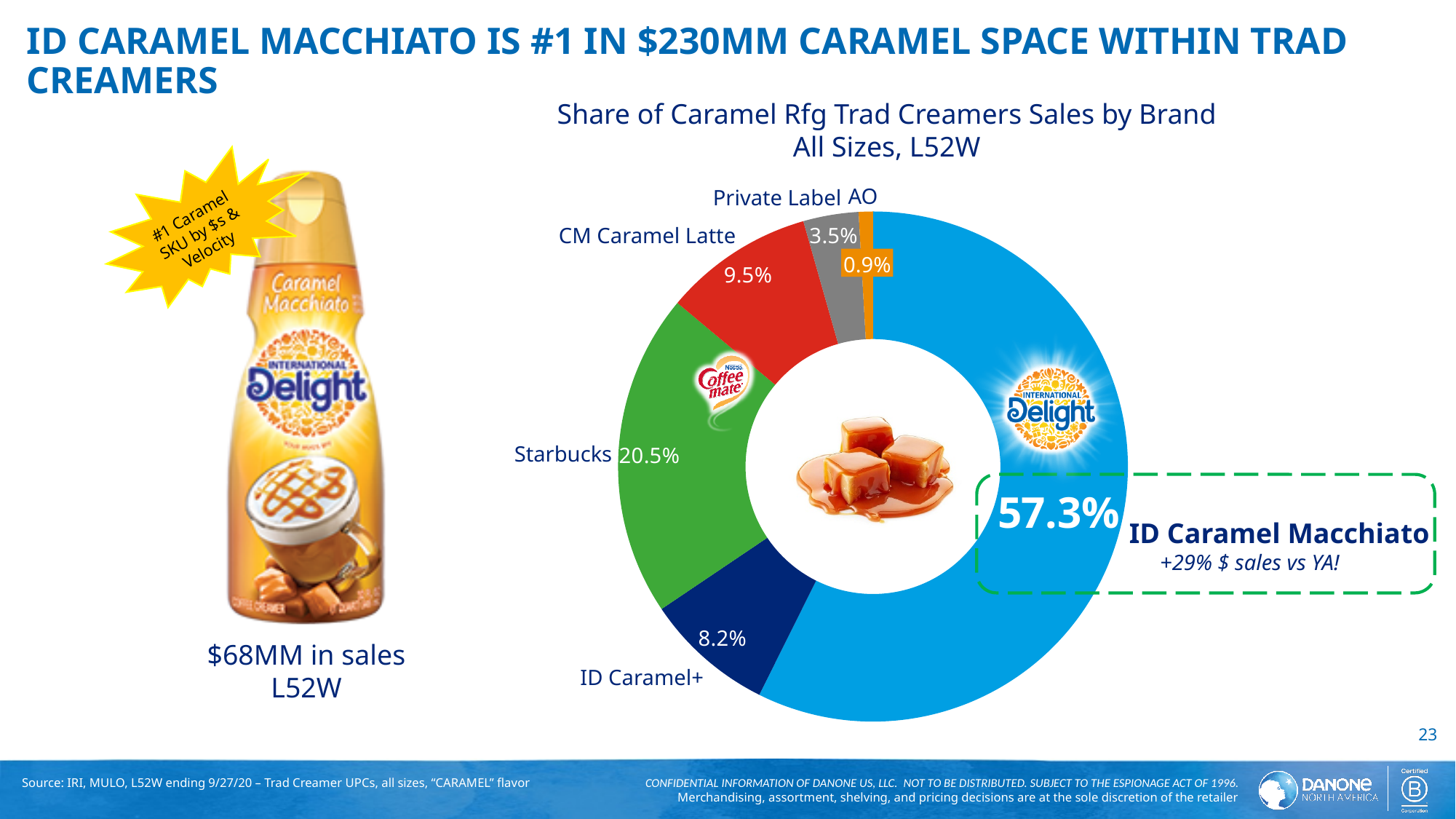
Which slice has the smallest share? AO What share does Private Label hold? 3.5% What is the share shown for Starbucks? 20.5% What share is shown for CM Caramel Latte? 9.5% Which has a larger share, CM Caramel Latte or ID Caramel+? CM Caramel Latte What is the title of the chart? Share of Caramel Rfg Trad Creamers Sales by Brand All Sizes, L52W What is the share for ID Caramel+? 8.2% Which brand has the largest share of the pie? ID Caramel Macchiato What type of chart is shown on the slide? Pie chart (donut) What share of Caramel Rfg Trad Creamers sales does ID Caramel Macchiato hold? 57.3% What is the difference in share between ID Caramel Macchiato and Starbucks? 36.8 percentage points How many slices does the pie chart have? 6